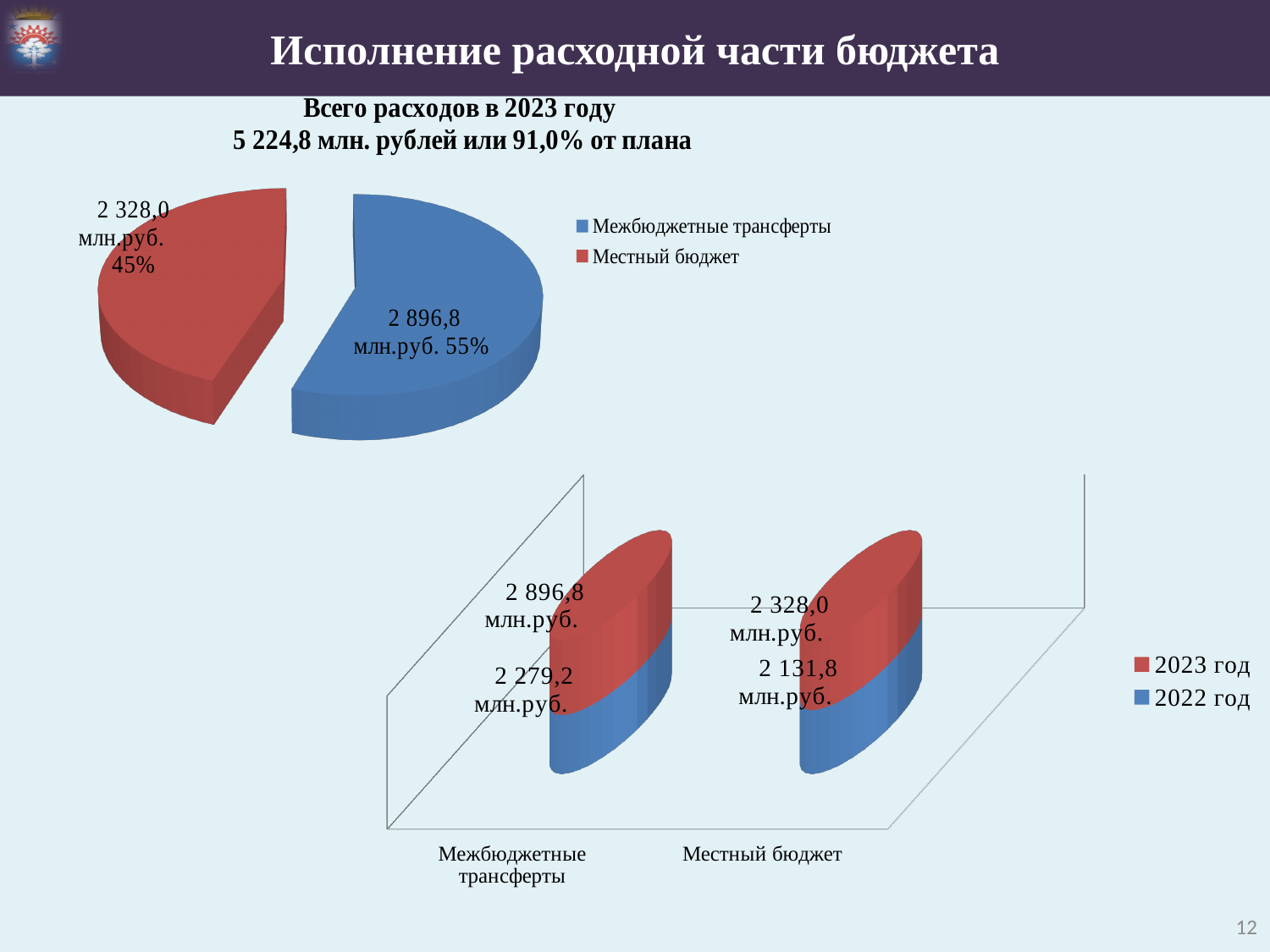
In the bottom bar chart, how many categories are shown on the x axis? 2 In the bottom bar chart, what is the difference between the 2023 год and 2022 год values for Местный бюджет in млн.руб.? 196,2 What type of chart is the bottom chart on the slide? bar chart In the bottom bar chart, what is the value for Межбюджетные трансферты in 2022 год? 2 279,2 млн.руб. How many series does the legend of the bottom bar chart list? 2 In the bottom bar chart, what is the value for Местный бюджет in 2023 год? 2 328,0 млн.руб. In the pie chart, what is the difference between Межбюджетные трансферты and Местный бюджет in млн.руб.? 568,8 What type of chart is the top chart on the slide? pie chart In the pie chart, what share does Местный бюджет have? 45% In the pie chart, which slice is larger, Межбюджетные трансферты or Местный бюджет? Межбюджетные трансферты In the bottom bar chart, which colour represents 2022 год? blue In the pie chart, what value is shown for Межбюджетные трансферты? 2 896,8 млн.руб.